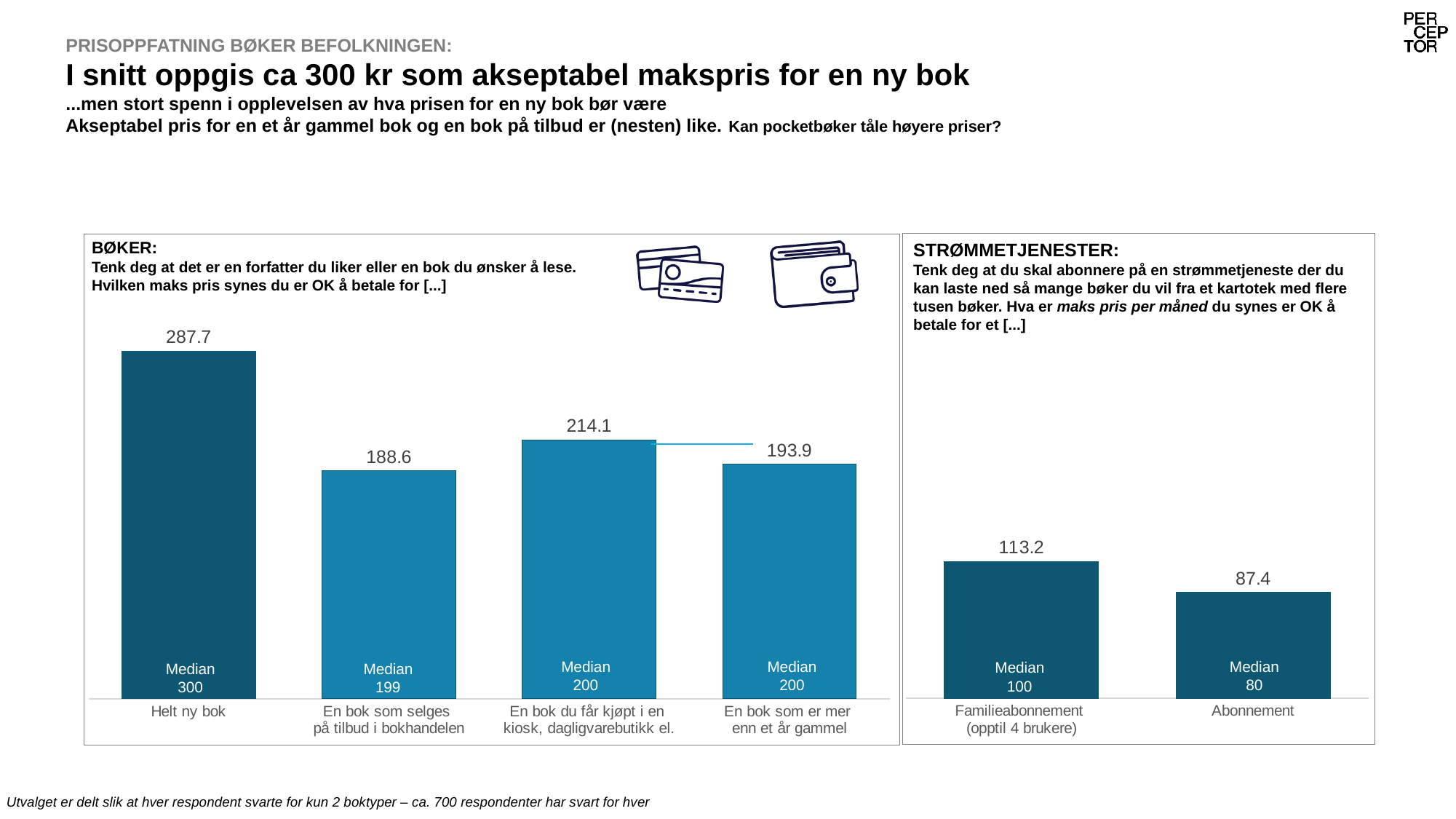
In the BØKER chart, what is the difference between the values for 'Helt ny bok' and 'En bok som selges på tilbud i bokhandelen'? 99.1 What type of chart is the STRØMMETJENESTER chart? Bar chart In the BØKER chart, which category has the highest value? Helt ny bok In the STRØMMETJENESTER chart, what is the value for 'Abonnement'? 87.4 In the BØKER chart, what is the value for 'Helt ny bok'? 287.7 In the BØKER chart, what median is shown for 'En bok som selges på tilbud i bokhandelen'? 199 In the BØKER chart, which is larger: the value for 'En bok du får kjøpt i en kiosk, dagligvarebutikk el.' or for 'En bok som er mer enn et år gammel'? En bok du får kjøpt i en kiosk, dagligvarebutikk el. In the STRØMMETJENESTER chart, what is the difference between the values for 'Familieabonnement (opptil 4 brukere)' and 'Abonnement'? 25.8 In the BØKER chart, what is the value for 'En bok du får kjøpt i en kiosk, dagligvarebutikk el.'? 214.1 In the BØKER chart, which category has the lowest value? En bok som selges på tilbud i bokhandelen In the STRØMMETJENESTER chart, what median is shown for 'Familieabonnement (opptil 4 brukere)'? 100 How many categories are shown in the BØKER chart? 4